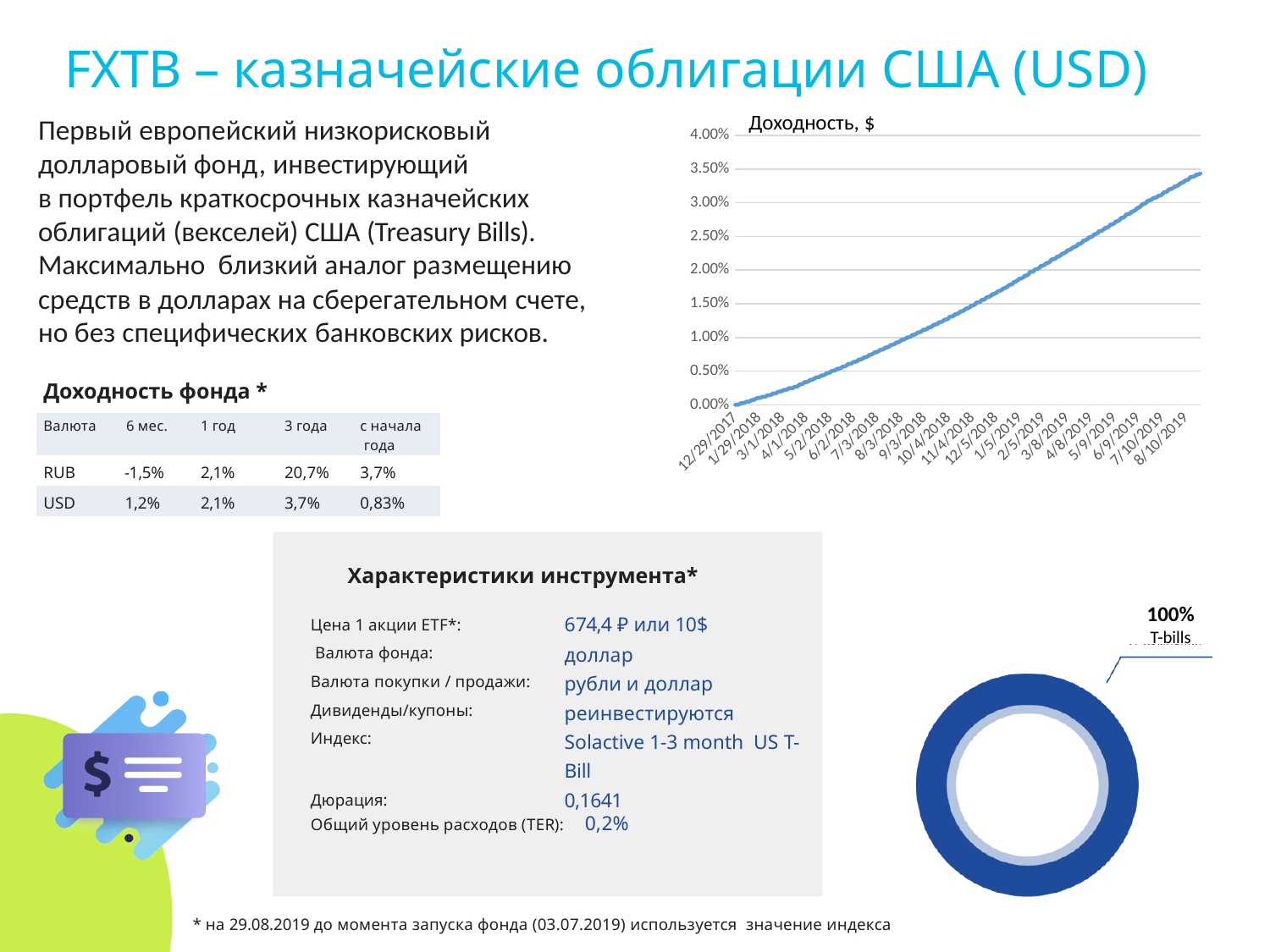
In the doughnut chart in the bottom right corner, what share does T-bills have? 100% How many categories does the doughnut chart in the bottom right corner show? 1 In the chart titled "Доходность, $", do the values rise or fall along the x axis from 12/29/2017 to 8/10/2019? rise What kind of chart is the chart titled "Доходность, $"? line chart What kind of chart is the chart in the bottom right corner of the slide? doughnut chart In the chart titled "Доходность, $", is the value at 4/1/2018 greater or less than 0.50%? less In the chart titled "Доходность, $", is the value at 7/10/2019 greater or less than 3.50%? less In the chart titled "Доходность, $", is the value at 8/10/2019 greater or less than 3.00%? greater In the chart titled "Доходность, $", what is the highest value shown on the y axis? 4.00% In the chart titled "Доходность, $", which date has the higher value: 12/29/2017 or 8/10/2019? 8/10/2019 What is the title of the line chart on the right of the slide? Доходность, $